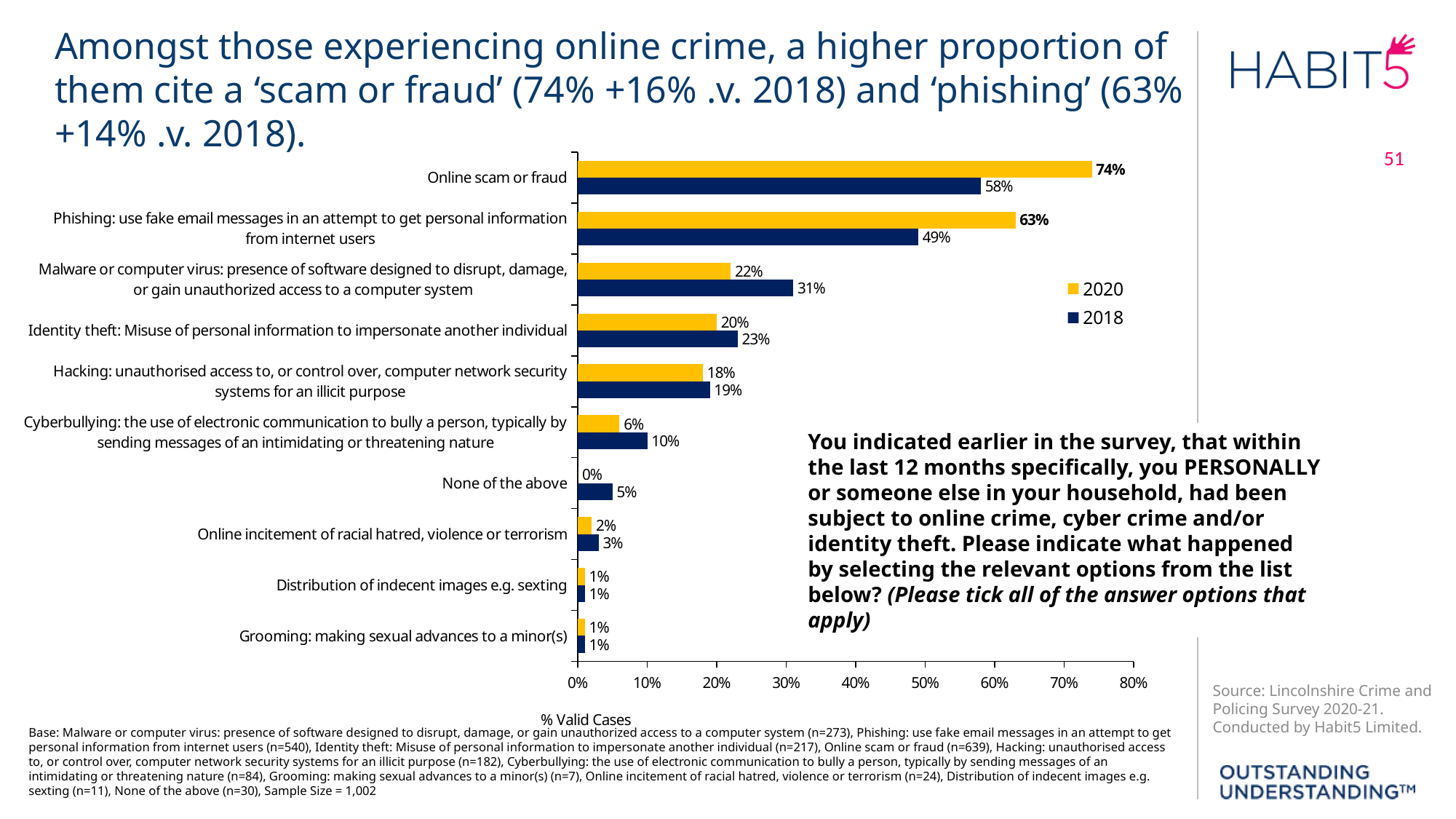
What is the difference between the 2020 and 2018 values for Online scam or fraud? 16% What is the 2018 value for Phishing? 49% Which category has the highest 2020 value? Online scam or fraud What is the 2018 value for Cyberbullying? 10% Which is larger for Malware or computer virus: the 2020 value or the 2018 value? 2018 Which colour represents the 2020 series in the legend? Yellow What is the 2020 value for Malware or computer virus? 22% Which category has the lowest 2020 value? None of the above What kind of chart is shown on the slide? Bar chart What is the 2020 value for Online scam or fraud? 74% How many categories are shown on the chart? 10 How many series does the legend list? 2